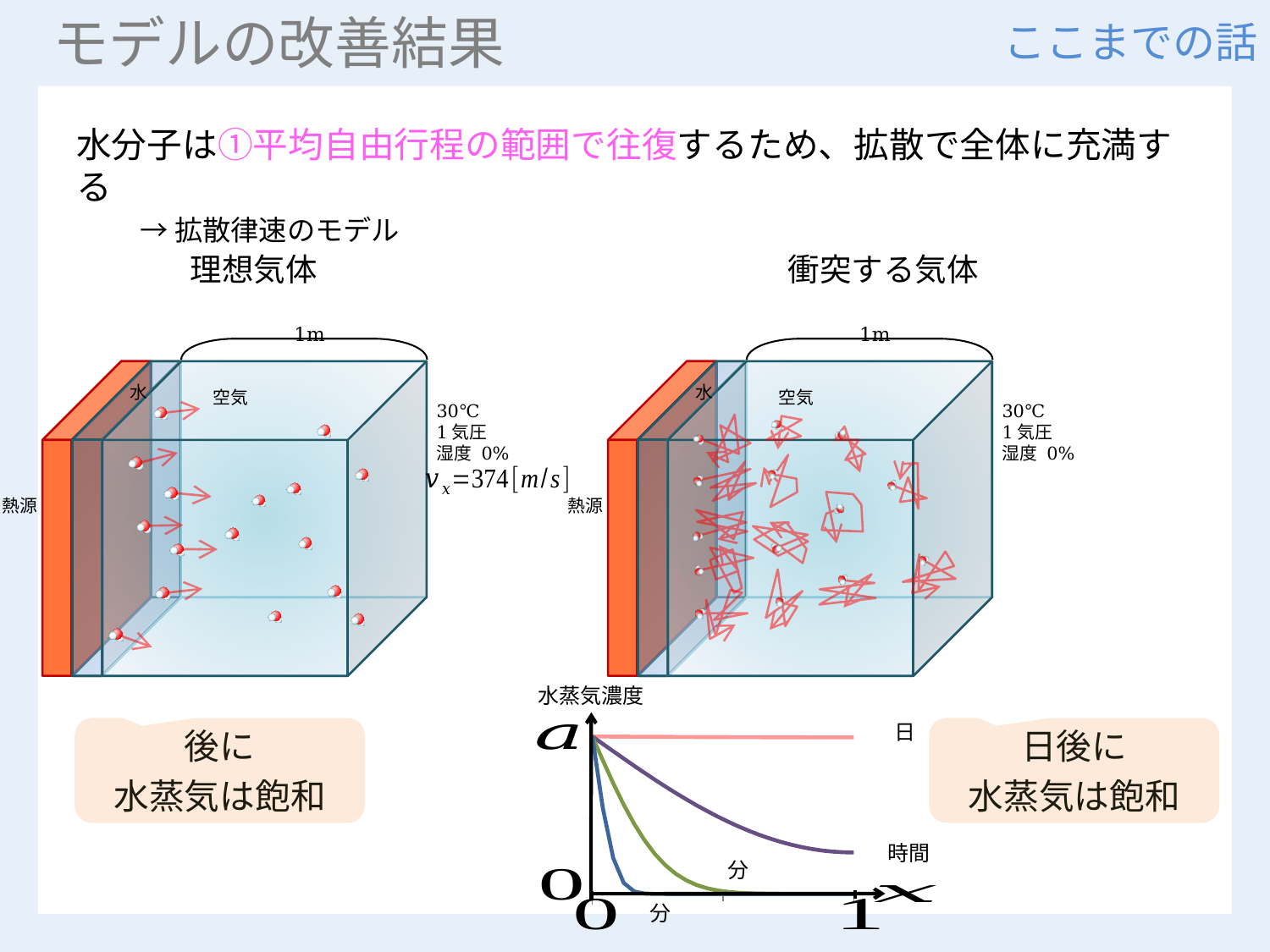
In the chart at the bottom of the slide, does the curve labelled 時間 rise or fall as x increases? fall In the chart at the bottom of the slide, what value is marked at the top of the vertical axis where the curves start? a In the chart at the bottom of the slide, which curve reaches the horizontal axis first, the blue one or the purple one? the blue one What kind of chart is shown at the bottom of the slide? line chart In the chart at the bottom of the slide, what value is marked at the right end of the horizontal axis? 1 In the chart at the bottom of the slide, which curve stays almost flat near the value a across the whole x range? 日 In the chart at the bottom of the slide, what is the label on the horizontal axis? x In the chart at the bottom of the slide, what is the label on the vertical axis? 水蒸気濃度 In the chart at the bottom of the slide, do the curves labelled 分 rise or fall as x increases? fall How many curves are plotted in the chart at the bottom of the slide? 4